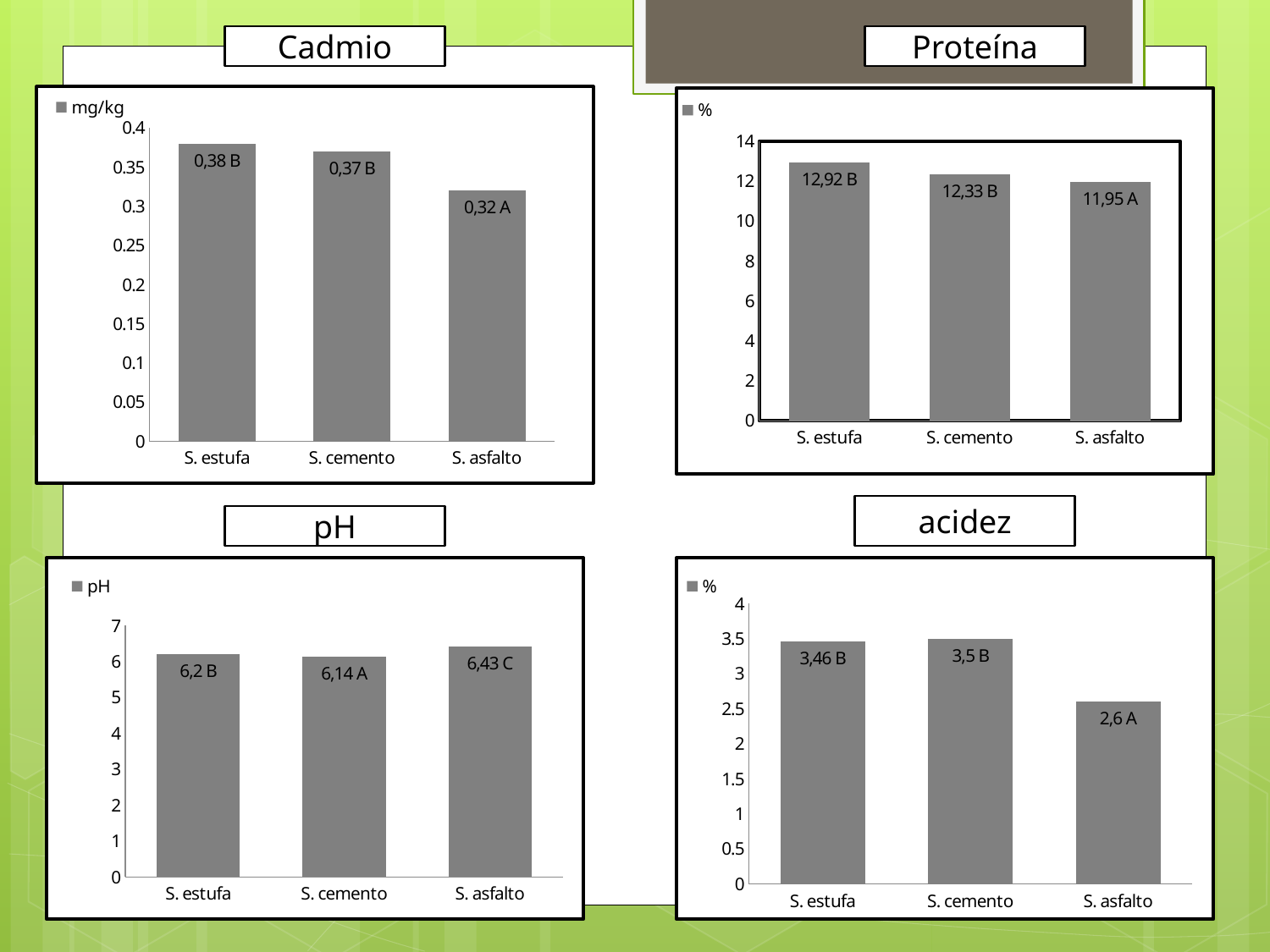
In the pH chart, which category has the highest value? S. asfalto How many categories are shown in the Cadmio chart? 3 In the acidez chart, what is the data label for S. asfalto? 2,6 A In the pH chart, what is the data label for S. cemento? 6,14 A In the Proteína chart, what is the data label for S. asfalto? 11,95 A What unit does the legend of the Cadmio chart show? mg/kg In the acidez chart, what is the difference between the values for S. cemento (3,5) and S. asfalto (2,6)? 0,9 In the Proteína chart, which category has the highest value? S. estufa In the Proteína chart, is the value for S. estufa greater or less than 12? greater In the Cadmio chart, what is the data label for S. estufa? 0,38 B What kind of chart is the acidez chart? bar chart In the Cadmio chart, which category has the lowest value? S. asfalto